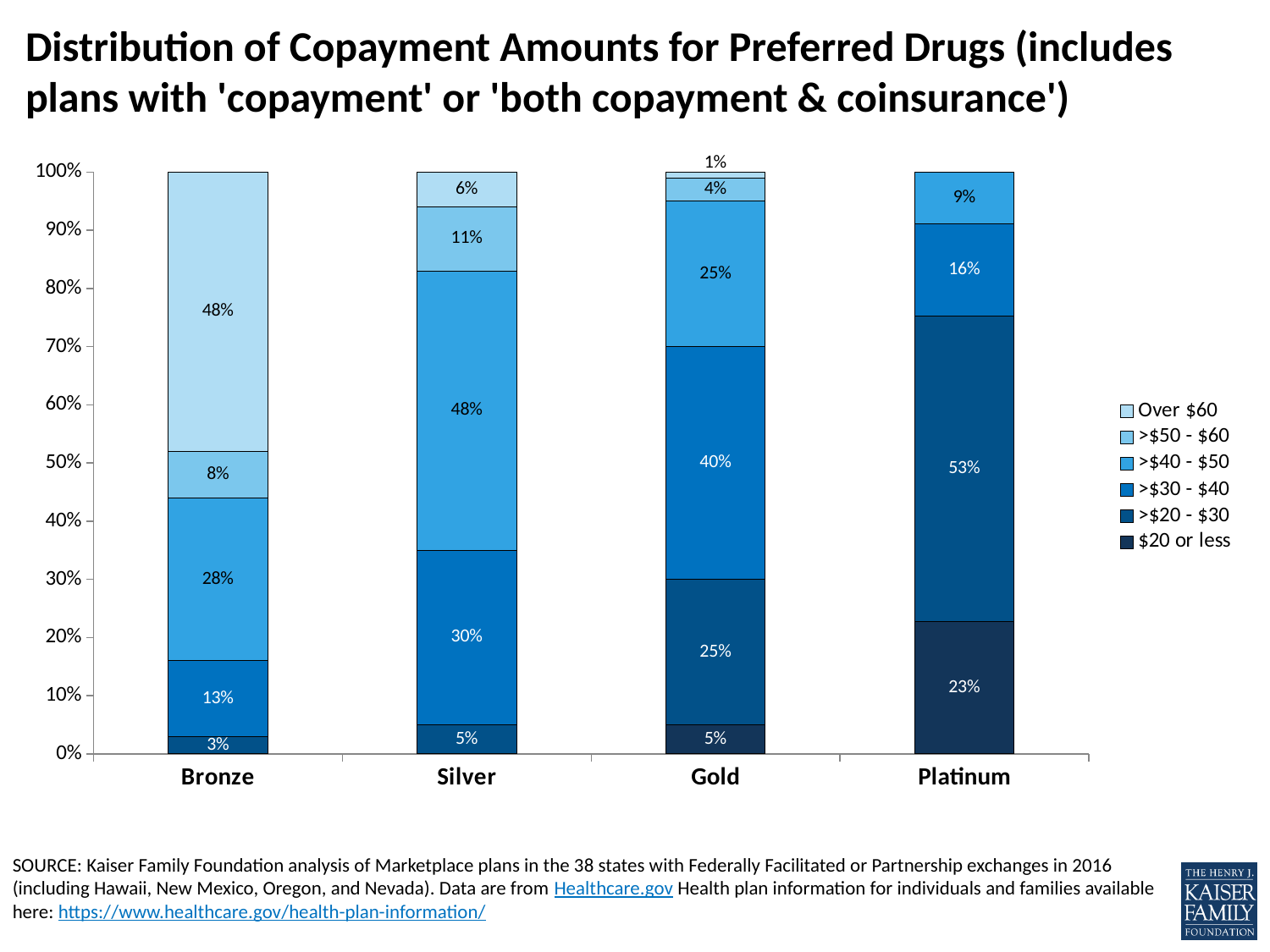
What is the value of the largest segment in the Gold bar? 40% What is the first entry listed in the legend? Over $60 How many plan categories are shown on the x axis? 4 How many series does the legend list? 6 What share of Platinum plans have a copayment of $20 or less? 23% What share of Bronze plans have a copayment of over $60? 48% Which plan type has the highest share of plans with a copayment of $20 or less? Platinum What kind of chart is shown on the slide? Stacked bar chart Which is larger: the '$20 or less' share for Gold or for Platinum? Platinum